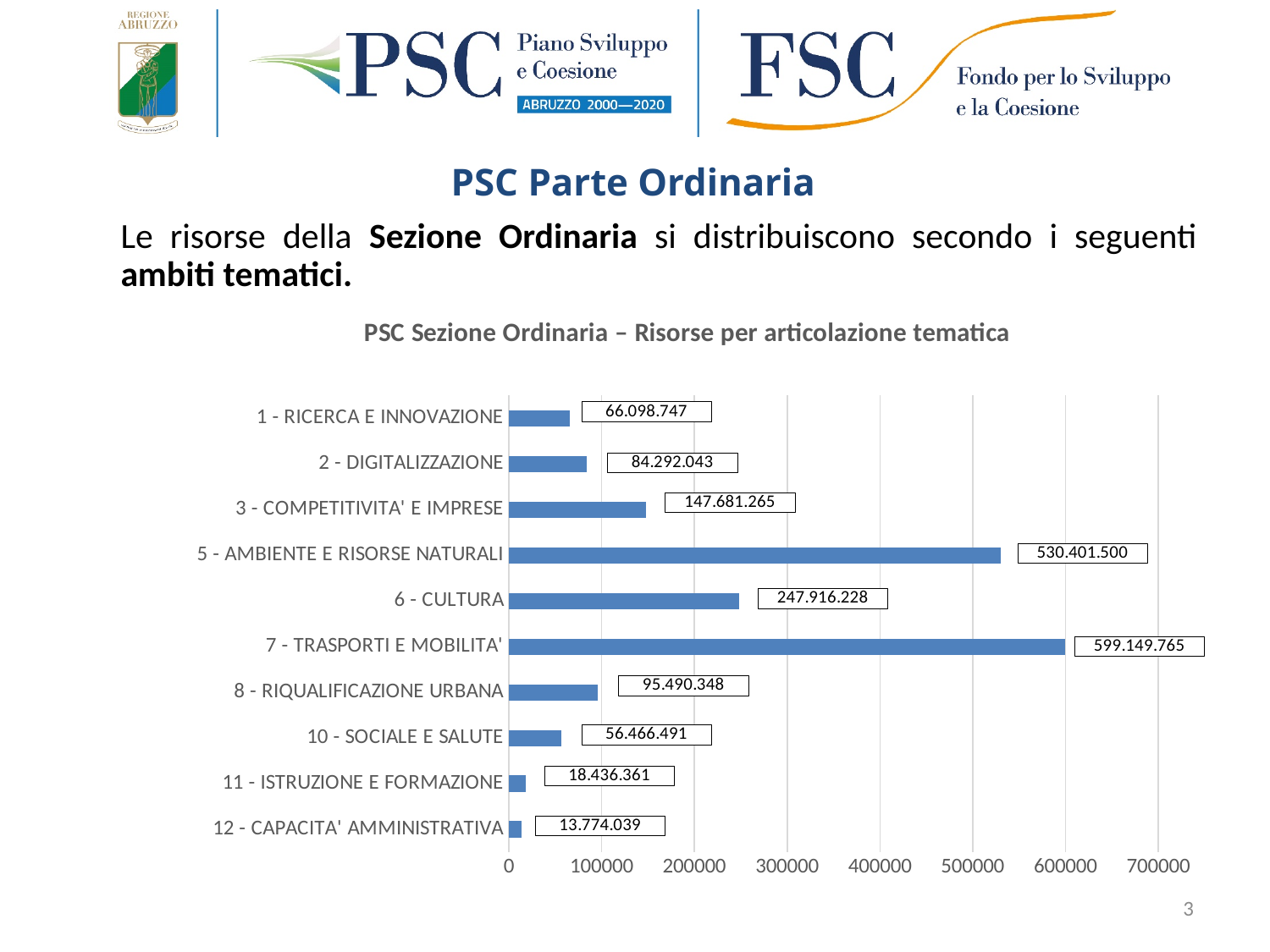
What is the difference between the values for 7 - TRASPORTI E MOBILITA' and 5 - AMBIENTE E RISORSE NATURALI? 68.748.265 Which category has the highest value? 7 - TRASPORTI E MOBILITA' What value is shown for 7 - TRASPORTI E MOBILITA'? 599.149.765 Which has the larger value, 8 - RIQUALIFICAZIONE URBANA or 2 - DIGITALIZZAZIONE? 8 - RIQUALIFICAZIONE URBANA What is the title of the chart? PSC Sezione Ordinaria – Risorse per articolazione tematica What value is shown for 12 - CAPACITA' AMMINISTRATIVA? 13.774.039 What is the difference between the values for 2 - DIGITALIZZAZIONE and 1 - RICERCA E INNOVAZIONE? 18.193.296 How many categories are shown in the chart? 10 What value is shown for 6 - CULTURA? 247.916.228 What kind of chart is shown on the slide? bar chart Which category has the lowest value? 12 - CAPACITA' AMMINISTRATIVA Is the bar for 3 - COMPETITIVITA' E IMPRESE greater or less than 100000 on the axis? greater